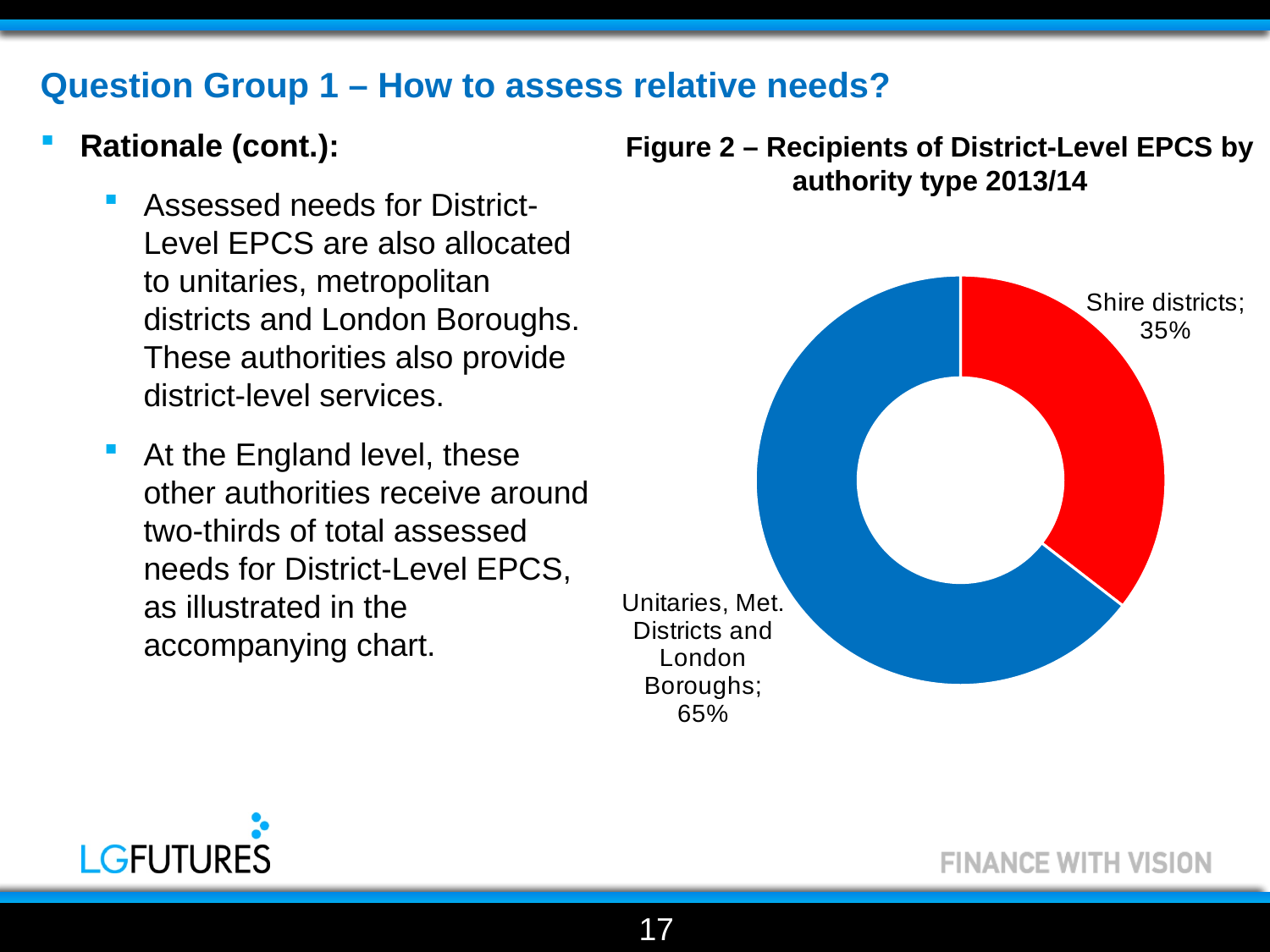
What is the title of the chart? Figure 2 – Recipients of District-Level EPCS by authority type 2013/14 Which is larger: the share for Shire districts or the share for Unitaries, Met. Districts and London Boroughs? Unitaries, Met. Districts and London Boroughs What kind of chart is shown on the slide? Pie chart (doughnut) Do the two shares in the chart add up to 100%? Yes Which authority type has the smallest share of the chart? Shire districts What colour is the Shire districts slice? Red What share of District-Level EPCS recipients are Shire districts? 35% What share of District-Level EPCS recipients are Unitaries, Met. Districts and London Boroughs? 65% How many categories are shown in the chart? 2 What is the difference in percentage points between the Unitaries, Met. Districts and London Boroughs share and the Shire districts share? 30 percentage points Which authority type has the largest share of the chart? Unitaries, Met. Districts and London Boroughs